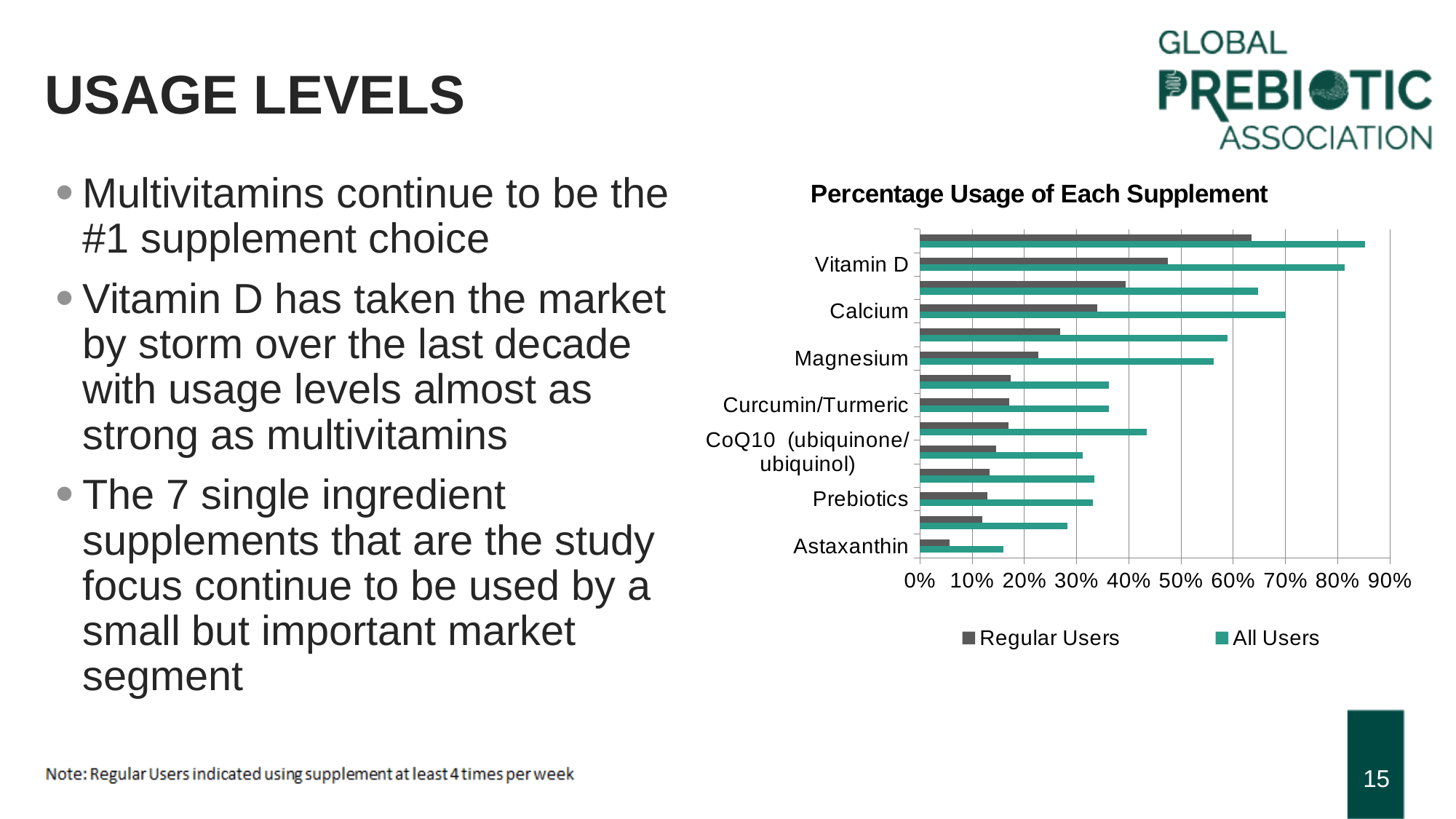
Is the Regular Users value for Astaxanthin greater or less than 10%? less How many series does the chart legend list? 2 What type of chart is shown on the slide? Bar chart Is the All Users value for Vitamin D greater or less than 70%? greater Which series is shown in teal in the chart? All Users Is the Regular Users value for Calcium greater or less than 40%? less What is the title of the chart? Percentage Usage of Each Supplement Which category has the lowest All Users value? Astaxanthin Which has the larger All Users value, Vitamin D or Calcium? Vitamin D